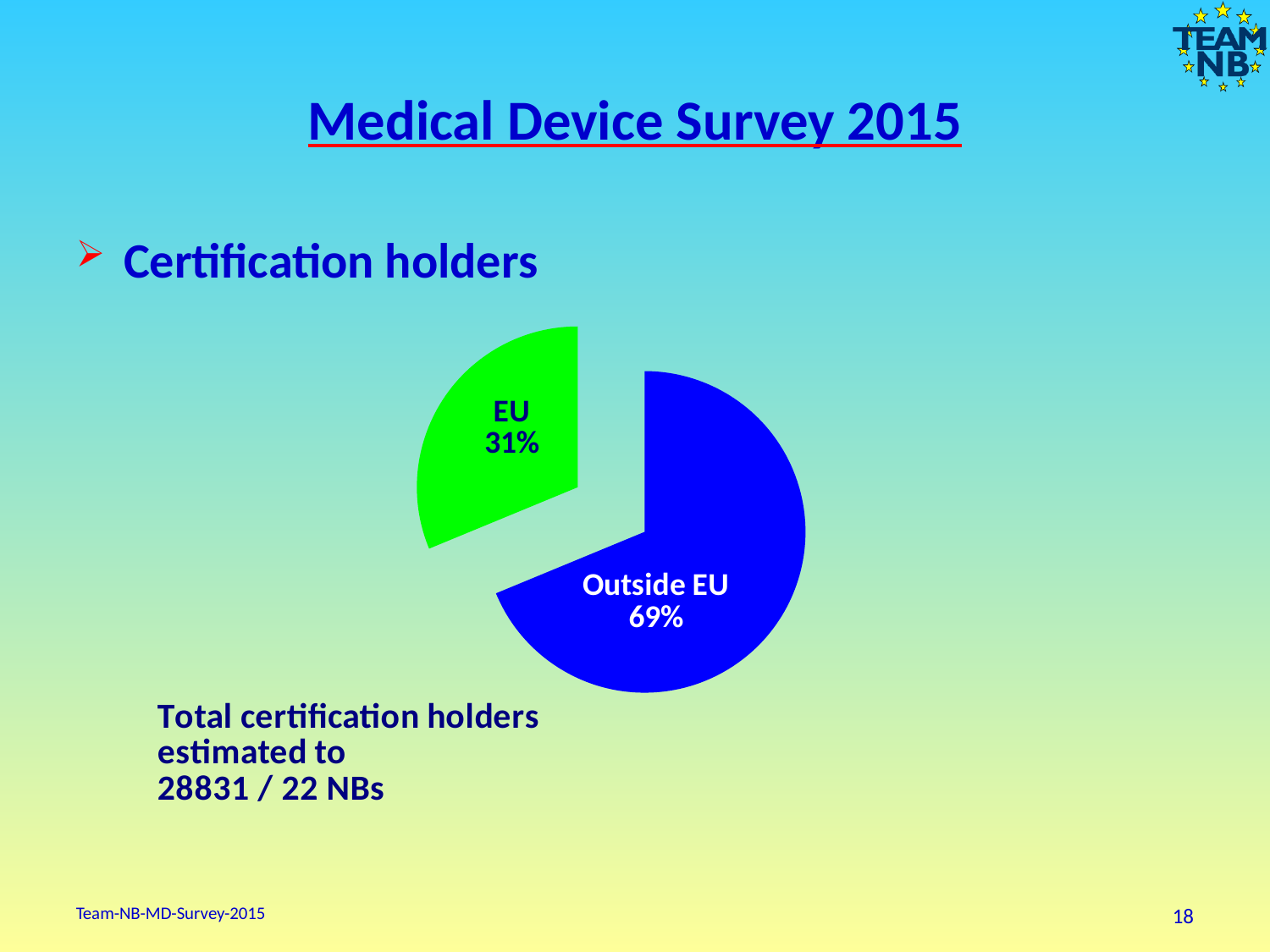
How many slices does the pie chart have? 2 What share of certification holders is from the EU? 31% What is the total number of certification holders estimated to, according to the text below the chart? 28831 / 22 NBs What kind of chart is shown on the slide? pie chart What is the difference in percentage points between the Outside EU and EU slices? 38 What colour is the Outside EU slice? blue Which slice of the pie is the smallest? EU What share of certification holders is from outside the EU? 69% Which is larger, the EU slice or the Outside EU slice? Outside EU Which slice of the pie is the largest? Outside EU What colour is the EU slice? green